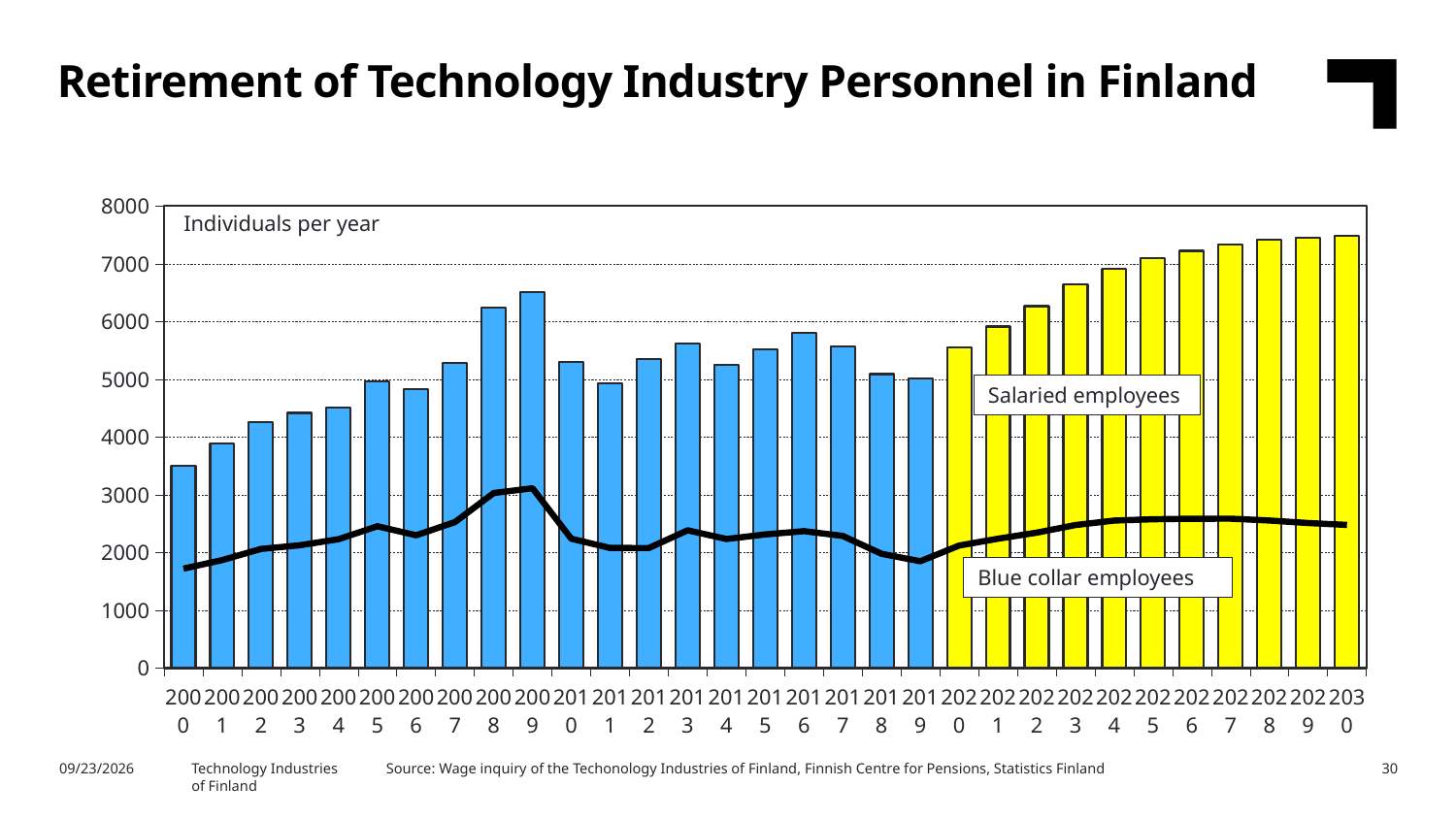
What unit label is shown inside the top-left of the plot area? Individuals per year Which year has the lowest bar? 2000 Do the bar values rise or fall from 2020 to 2030? rise How many years (bars) are plotted along the x axis? 31 What kind of chart is shown on the slide? A bar chart combined with a line Is the bar value for 2000 greater or less than 4000? less Is the value of the black line in 2000 greater or less than 2000? less Among the blue bars (2000–2019), which year has the highest bar? 2009 Is the bar value for 2030 greater or less than 7000? greater What colour are the bars for the years 2020 onwards? Yellow In which year does the black line reach its highest point? 2009